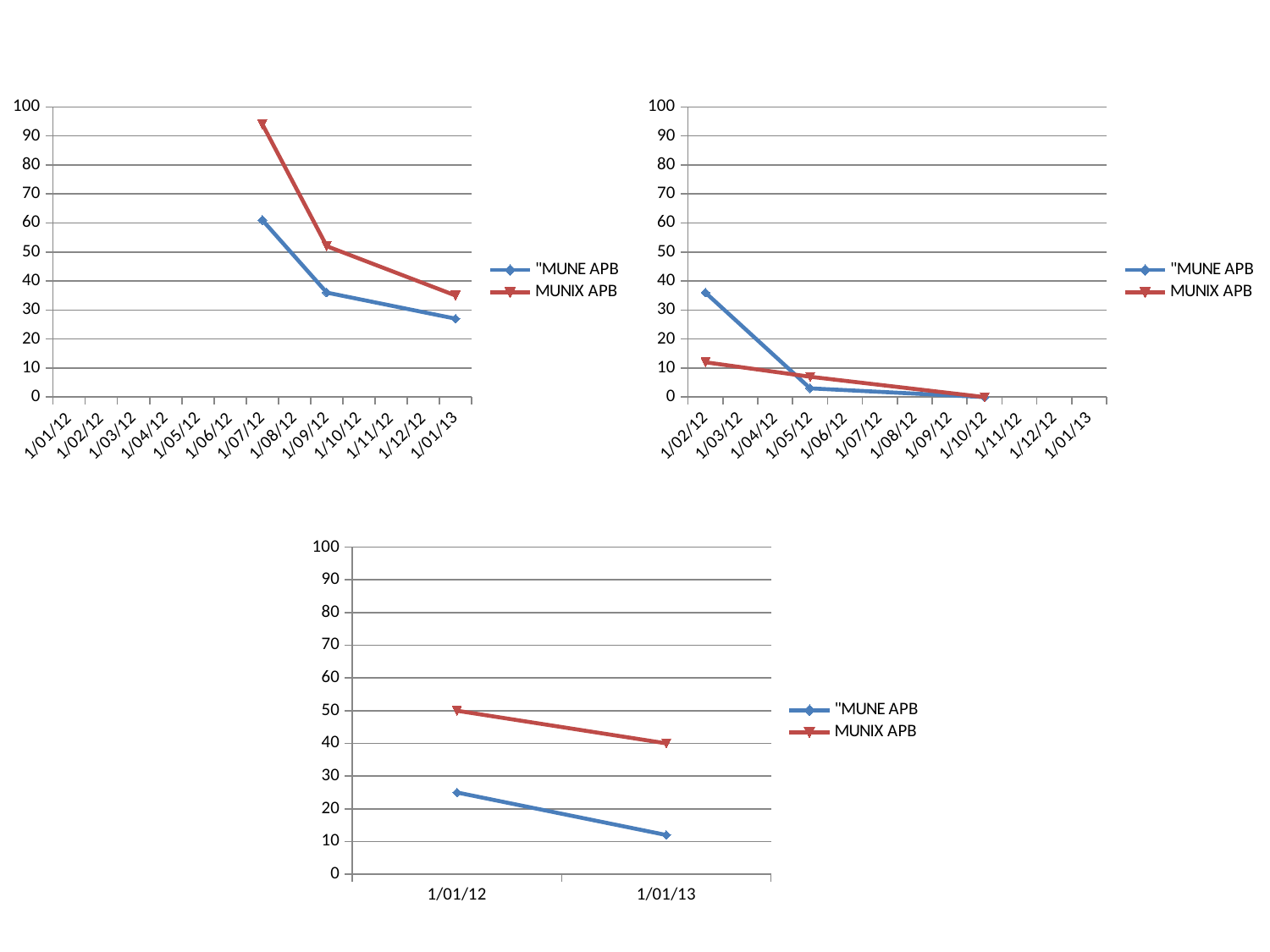
In the bottom chart, do the "MUNE APB values rise or fall from 1/01/12 to 1/01/13? fall How many x-axis categories does the bottom chart show? 2 In the top-left chart, is the value for MUNIX APB at 1/07/12 greater or less than 90? greater In the top-right chart, at which date does "MUNE APB reach its highest value? 1/02/12 What kind of chart is the top-left chart? line chart In the top-right chart, is the value for "MUNE APB at 1/02/12 greater or less than 30? greater How many series does the legend of the top-left chart list? 2 In the top-left chart, is the value for "MUNE APB at 1/01/13 greater or less than 30? less In the top-right chart, which series has the higher value at 1/02/12? "MUNE APB In the top-left chart, do the MUNIX APB values rise or fall from 1/07/12 to 1/01/13? fall In the top-left chart, which series has the higher value at 1/09/12? MUNIX APB